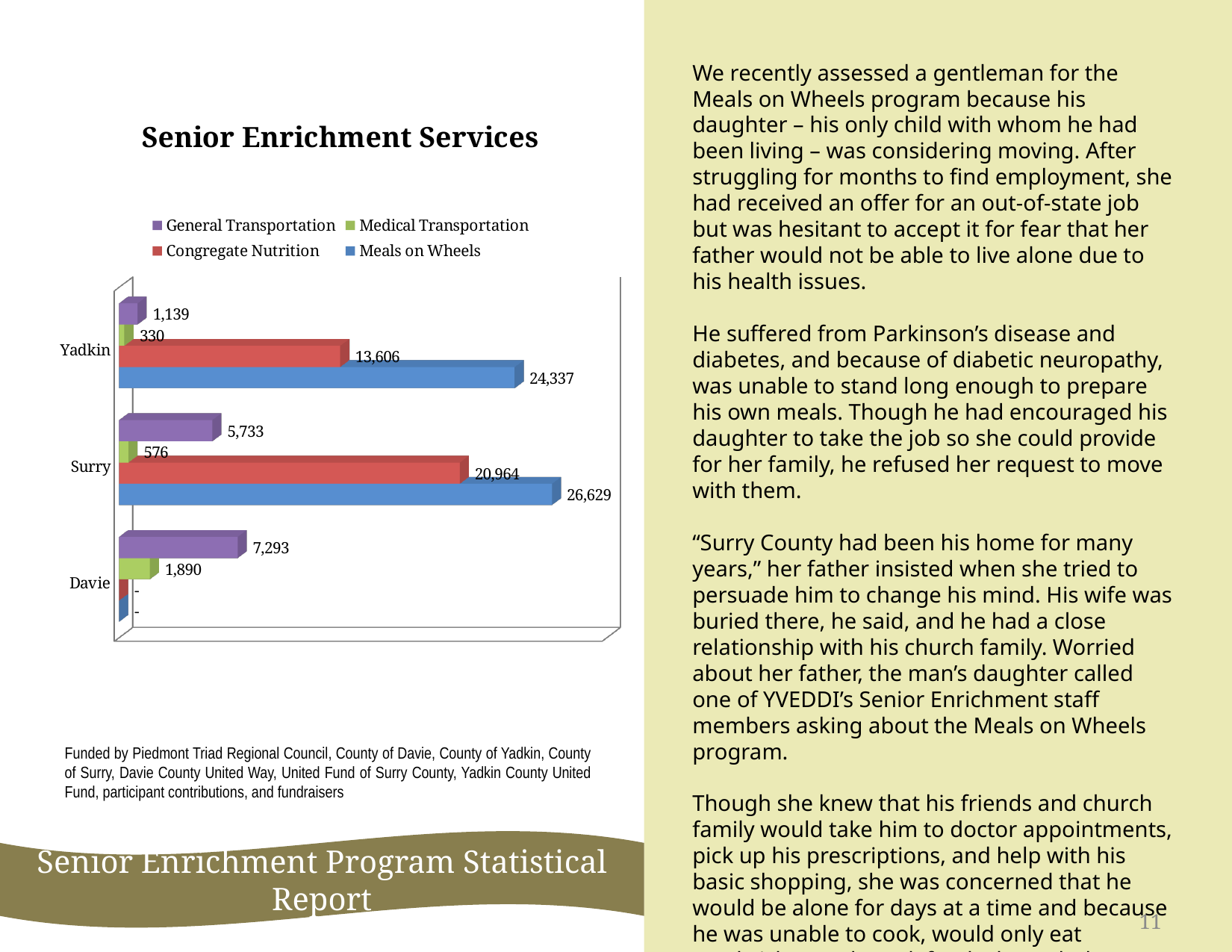
What is the Meals on Wheels value for Surry? 26,629 What is the General Transportation value for Davie? 7,293 Which county has the lowest Medical Transportation value? Yadkin What is the difference between the Meals on Wheels values for Surry and Yadkin? 2,292 How many counties are shown on the chart? 3 How many series does the legend list? 4 What is the Congregate Nutrition value for Yadkin? 13,606 Which county has the highest Meals on Wheels value? Surry What is the title of the chart? Senior Enrichment Services What is the Medical Transportation value for Yadkin? 330 Which is larger, the General Transportation value for Surry or for Davie? Davie What kind of chart is shown on the slide? Bar chart